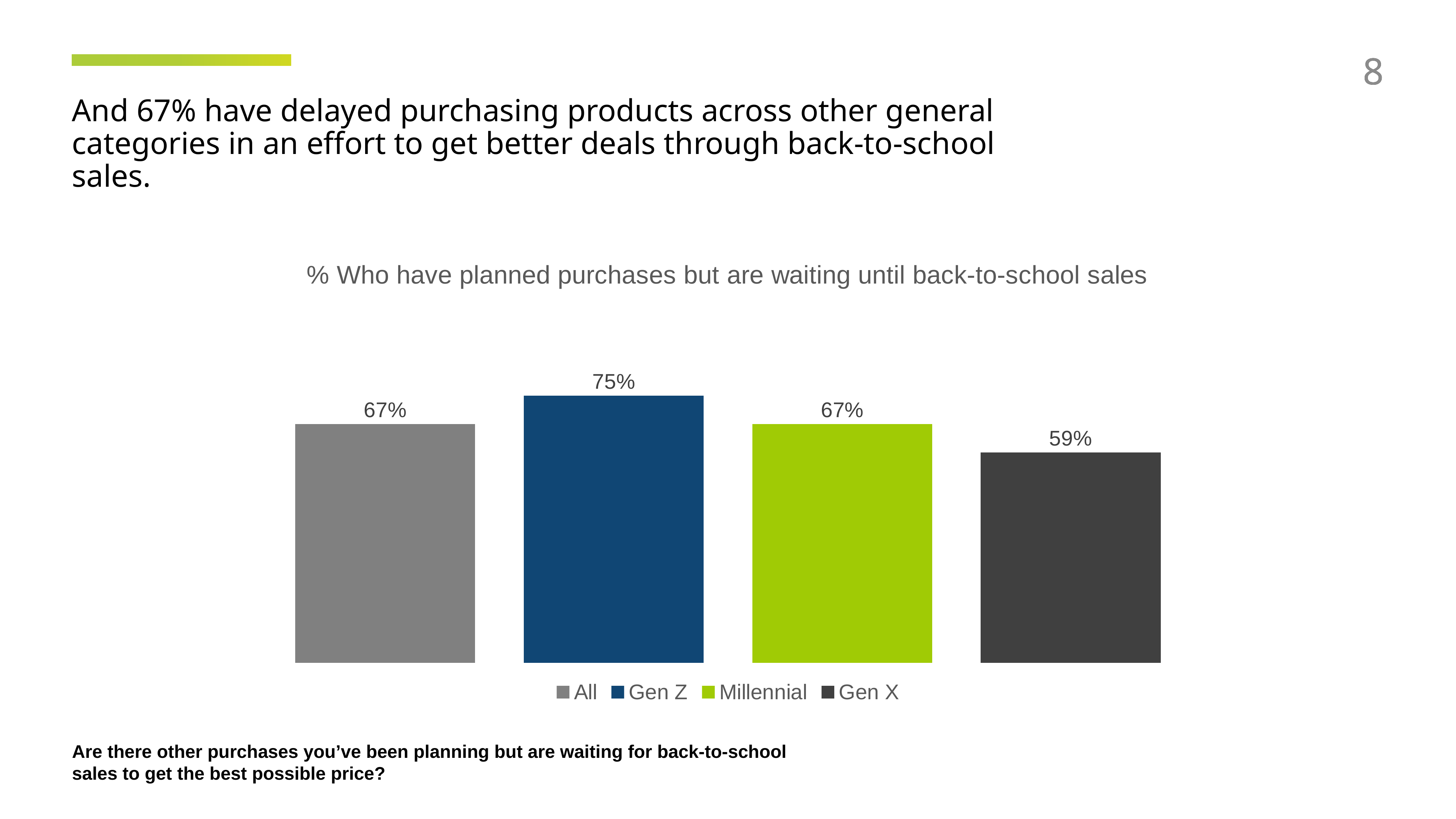
How many bars are shown in the chart? 4 What is the difference between the values for Millennial and Gen X? 8% What is the value for Millennial? 67% What is the value for All? 67% What is the title of the chart? % Who have planned purchases but are waiting until back-to-school sales Which group has the highest value? Gen Z Which is larger, the value for Gen Z or the value for Millennial? Gen Z What is the difference between the values for Gen Z and Gen X? 16% What kind of chart is shown on the slide? Bar chart Which group has the lowest value? Gen X What is the value for Gen Z? 75% What is the value for Gen X? 59%